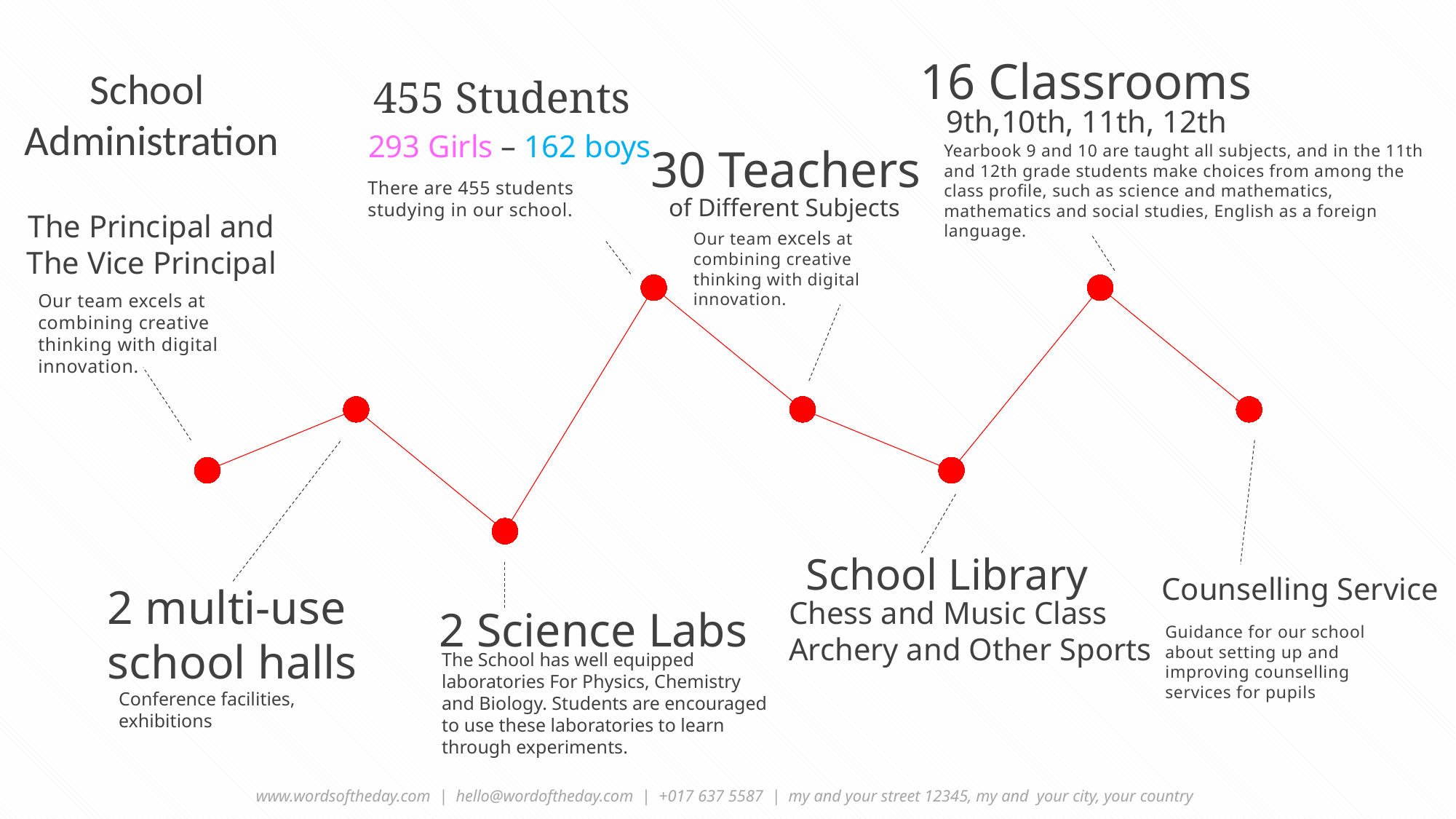
Which point is higher on the line: the one for '30 Teachers' or the one for 'School Library'? 30 Teachers Does the line rise or fall between the point for '2 multi-use school halls' and the point for '2 Science Labs'? fall How many data points (red markers) are plotted on the line? 8 Does the line rise or fall between the point for 'School Library' and the point for '16 Classrooms'? rise What kind of chart is shown on the slide? line chart What colour are the line and its markers? red Which callout is connected to the lowest point on the line? 2 Science Labs